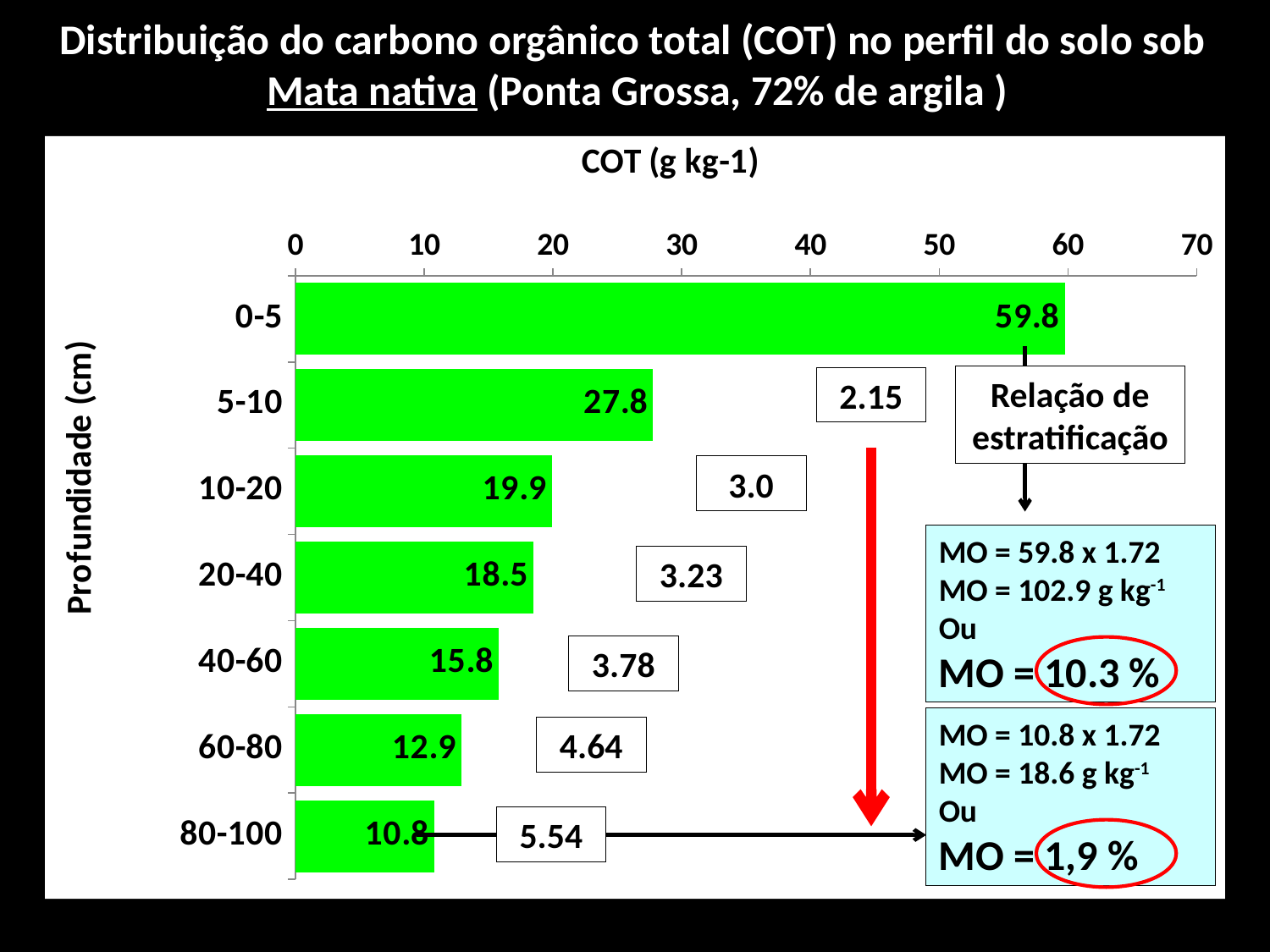
What is the COT value for the 80-100 cm depth? 10.8 Which depth has the lowest COT value? 80-100 What is the difference between the COT values for 40-60 cm and 60-80 cm? 2.9 Which depth has the highest COT value? 0-5 What is the difference between the COT values for 0-5 cm and 5-10 cm? 32.0 How many depth categories are shown in the chart? 7 What kind of chart is shown on the slide? bar chart Is the COT value for 5-10 cm greater or less than 30? less What is the COT value for the 0-5 cm depth? 59.8 Which has a larger COT value, 10-20 cm or 40-60 cm? 10-20 What is the title of the chart's horizontal axis? COT (g kg-1) What is the COT value for the 20-40 cm depth? 18.5